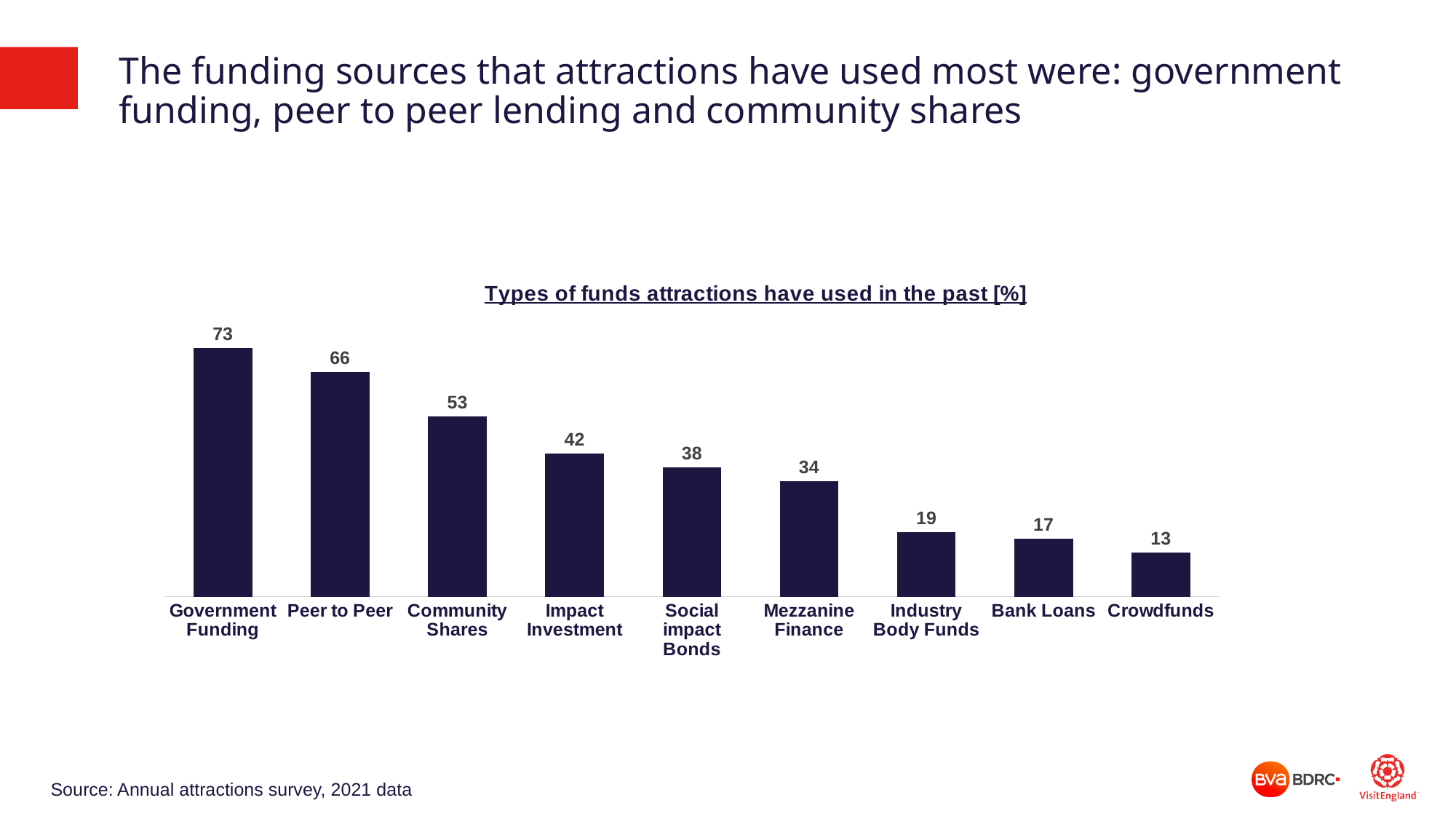
How many funding types are shown in the chart? 9 What is the value for Social impact Bonds? 38 Which funding type has the highest value? Government Funding What is the title of the chart? Types of funds attractions have used in the past [%] What is the value for Government Funding? 73 Do the values rise or fall from left to right along the x axis? Fall What is the difference between the values for Peer to Peer and Community Shares? 13 What is the value for Bank Loans? 17 What is the difference between the values for Impact Investment and Mezzanine Finance? 8 Which funding type has the lowest value? Crowdfunds Which is larger, the value for Industry Body Funds or the value for Crowdfunds? Industry Body Funds What kind of chart is shown on the slide? Bar chart